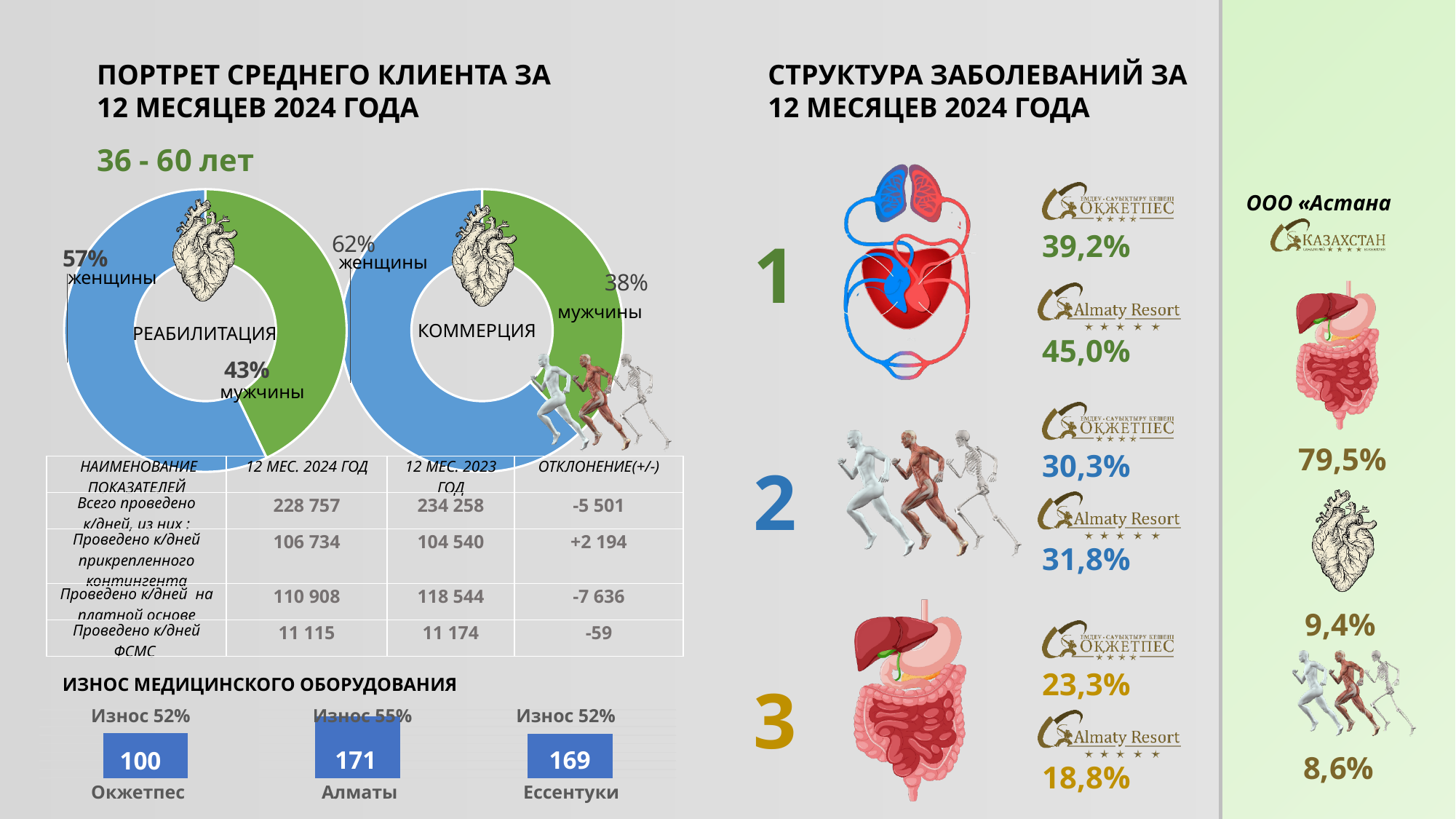
In the ИЗНОС МЕДИЦИНСКОГО ОБОРУДОВАНИЯ bar chart, what colour are the bars? Blue In the РЕАБИЛИТАЦИЯ donut chart, what is the difference between the женщины and мужчины shares? 14% In the ИЗНОС МЕДИЦИНСКОГО ОБОРУДОВАНИЯ bar chart, what is the value for Алматы? 171 What type of chart is used for РЕАБИЛИТАЦИЯ and КОММЕРЦИЯ? Donut (pie) chart How many segments does the РЕАБИЛИТАЦИЯ donut chart have? 2 In the КОММЕРЦИЯ donut chart, what share is мужчины? 38% In the КОММЕРЦИЯ donut chart, what share is женщины? 62% In the КОММЕРЦИЯ donut chart, which segment is larger, женщины or мужчины? женщины In the КОММЕРЦИЯ donut chart, what is the difference between the женщины and мужчины shares? 24% In the ИЗНОС МЕДИЦИНСКОГО ОБОРУДОВАНИЯ bar chart, which category has the lowest value? Окжетпес In the РЕАБИЛИТАЦИЯ donut chart, what share is женщины? 57% In the РЕАБИЛИТАЦИЯ donut chart, what share is мужчины? 43%